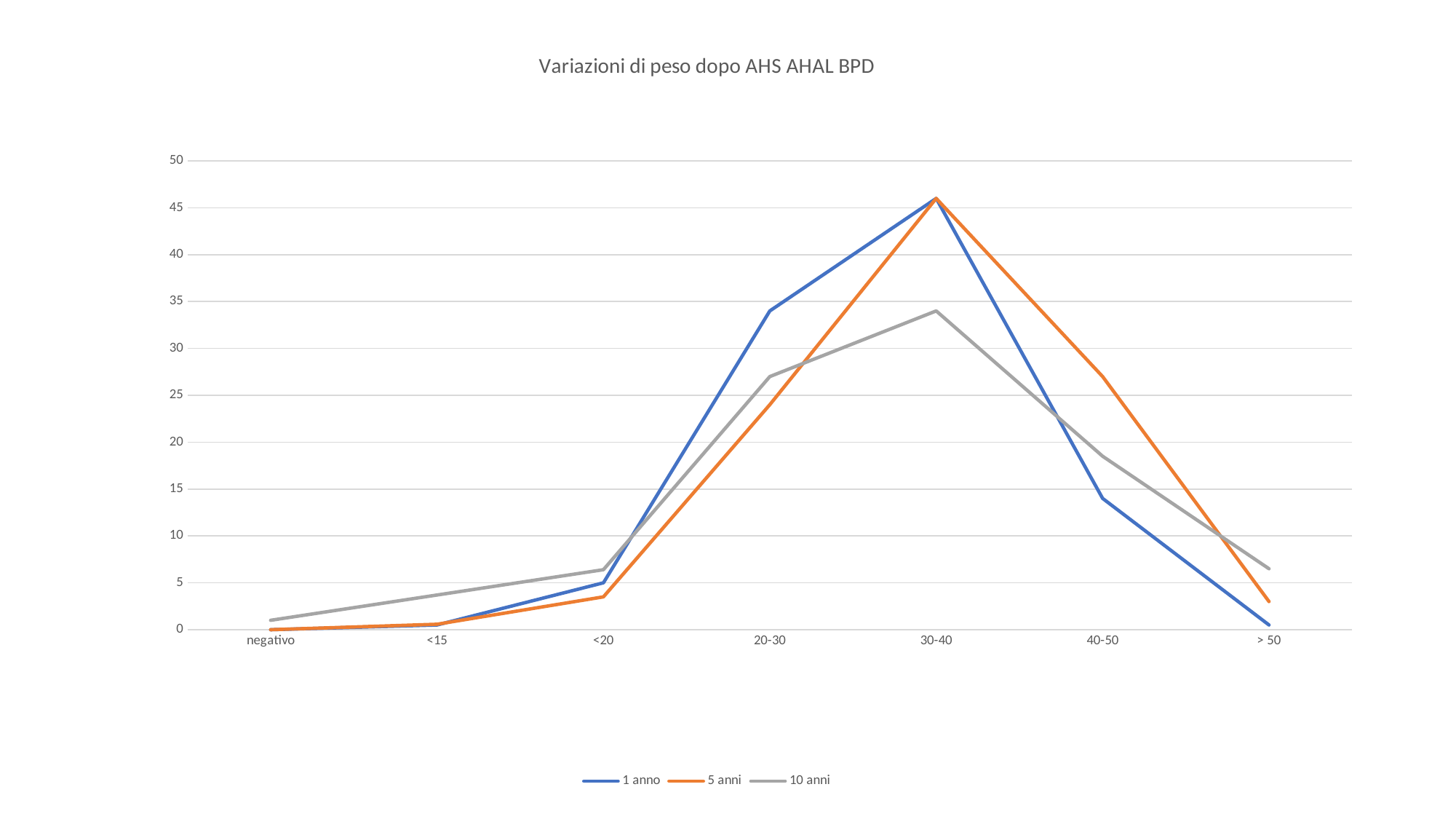
At 40-50, which series has the larger value, 1 anno or 5 anni? 5 anni Is the value for 1 anno at 20-30 greater or less than 30? greater What kind of chart is shown on the slide? line chart How many categories are shown on the x axis? 7 What is the title of the chart? Variazioni di peso dopo AHS AHAL BPD How many series does the legend list? 3 Which category has the highest value for the 10 anni series? 30-40 At 20-30, which series has the larger value, 1 anno or 5 anni? 1 anno Does the 1 anno series rise or fall from 30-40 to > 50? fall Is the value for 10 anni at 30-40 greater or less than 30? greater Which category has the highest value for the 1 anno series? 30-40 Is the value for 5 anni at 20-30 greater or less than 25? less